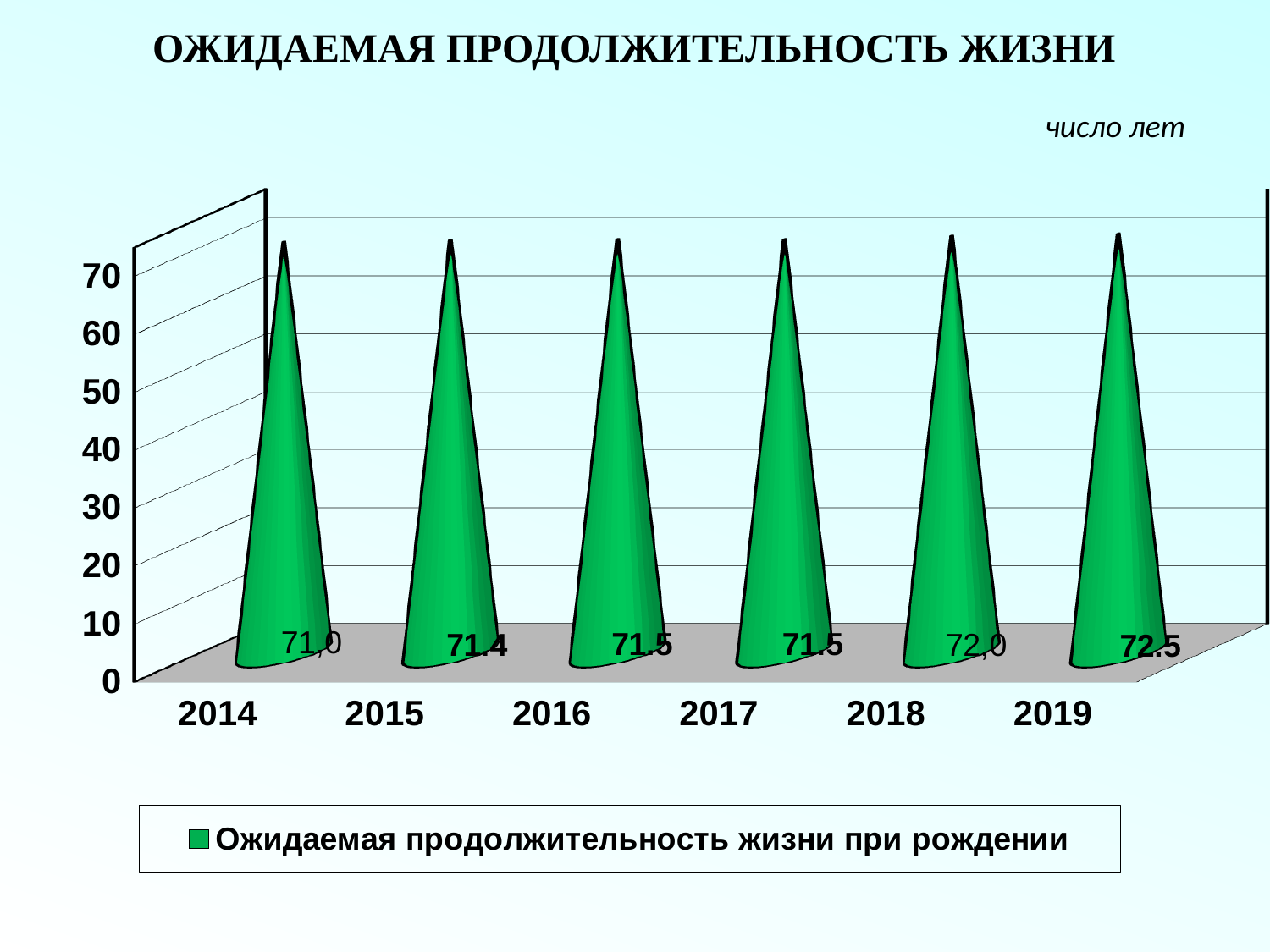
Do the values rise or fall from 2014 to 2019? rise Which year has the lowest life expectancy value? 2014 What is the life expectancy value shown for 2014? 71,0 Which is larger, the value for 2015 or the value for 2019? 2019 What is the life expectancy value shown for 2018? 72,0 What is the life expectancy value shown for 2019? 72.5 By how much does the value for 2019 exceed the value for 2014? 1.5 How many years are shown on the x axis? 6 Is the value for 2017 greater or less than 60? greater How many series does the legend list? 1 What is the life expectancy value shown for 2016? 71.5 Which year has the highest life expectancy value? 2019